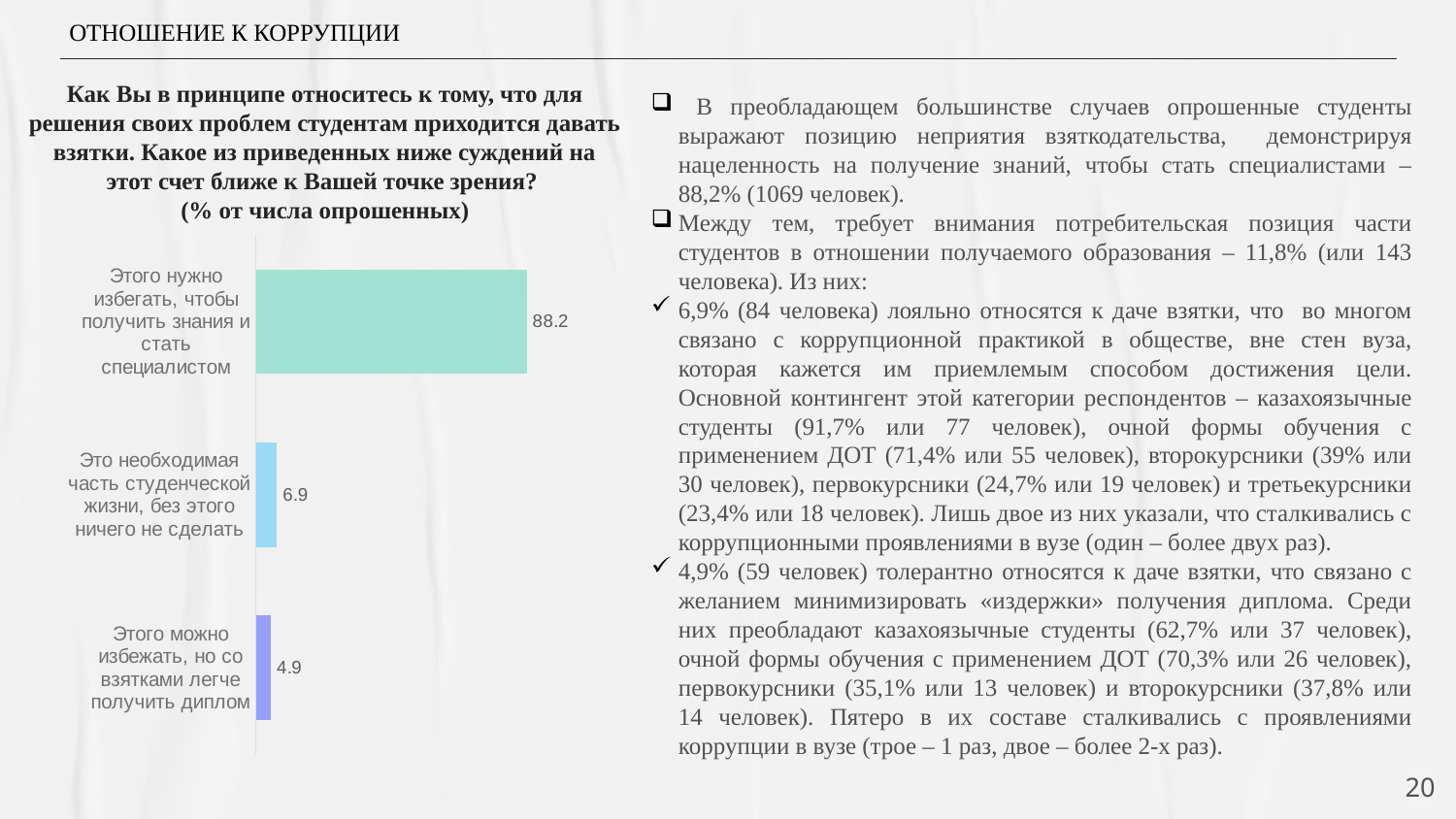
Which category has the lowest value? Этого можно избежать, но со взятками легче получить диплом What is the value for "Этого нужно избегать, чтобы получить знания и стать специалистом"? 88.2 What is the difference between the values for "Это необходимая часть студенческой жизни, без этого ничего не сделать" and "Этого можно избежать, но со взятками легче получить диплом"? 2.0 What is the difference between the highest and lowest values in the chart? 83.3 How many categories does the bar chart show? 3 Which category has the highest value? Этого нужно избегать, чтобы получить знания и стать специалистом What type of chart is shown on the slide? bar chart Which is larger: the value for "Это необходимая часть студенческой жизни, без этого ничего не сделать" or for "Этого можно избежать, но со взятками легче получить диплом"? Это необходимая часть студенческой жизни, без этого ничего не сделать What unit do the chart values represent, according to the chart title? % от числа опрошенных What colour is the bar for "Этого можно избежать, но со взятками легче получить диплом"? purple What is the value for "Это необходимая часть студенческой жизни, без этого ничего не сделать"? 6.9 What is the value for "Этого можно избежать, но со взятками легче получить диплом"? 4.9